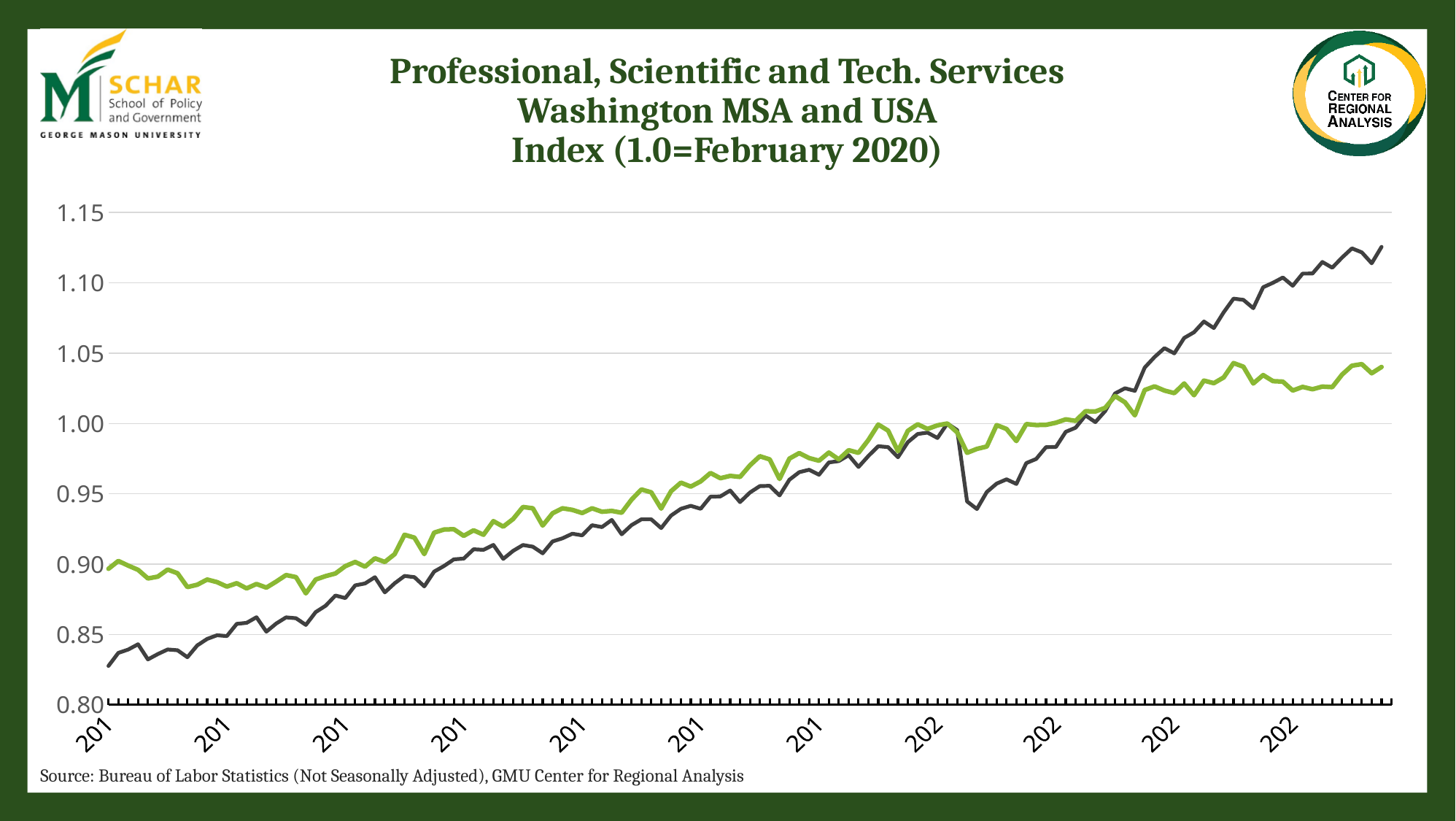
What kind of chart is shown on the slide? Line chart Which line reaches the highest value anywhere on the chart, the green line or the dark gray line? The dark gray line Is the final value of the dark gray line at the right end of the chart greater or less than 1.10? greater What is the title of the chart? Professional, Scientific and Tech. Services Washington MSA and USA Index (1.0=February 2020) At the right end of the chart, which line is higher, the green line or the dark gray line? The dark gray line What is the highest value shown on the vertical axis? 1.15 Overall, do the values of the dark gray line rise or fall from left to right? Rise At the left end of the chart, which line is higher, the green line or the dark gray line? The green line Is the final value of the green line at the right end of the chart greater or less than 1.00? greater How many lines are plotted on the chart? 2 Is the starting value of the dark gray line at the left end of the chart greater or less than 0.85? less